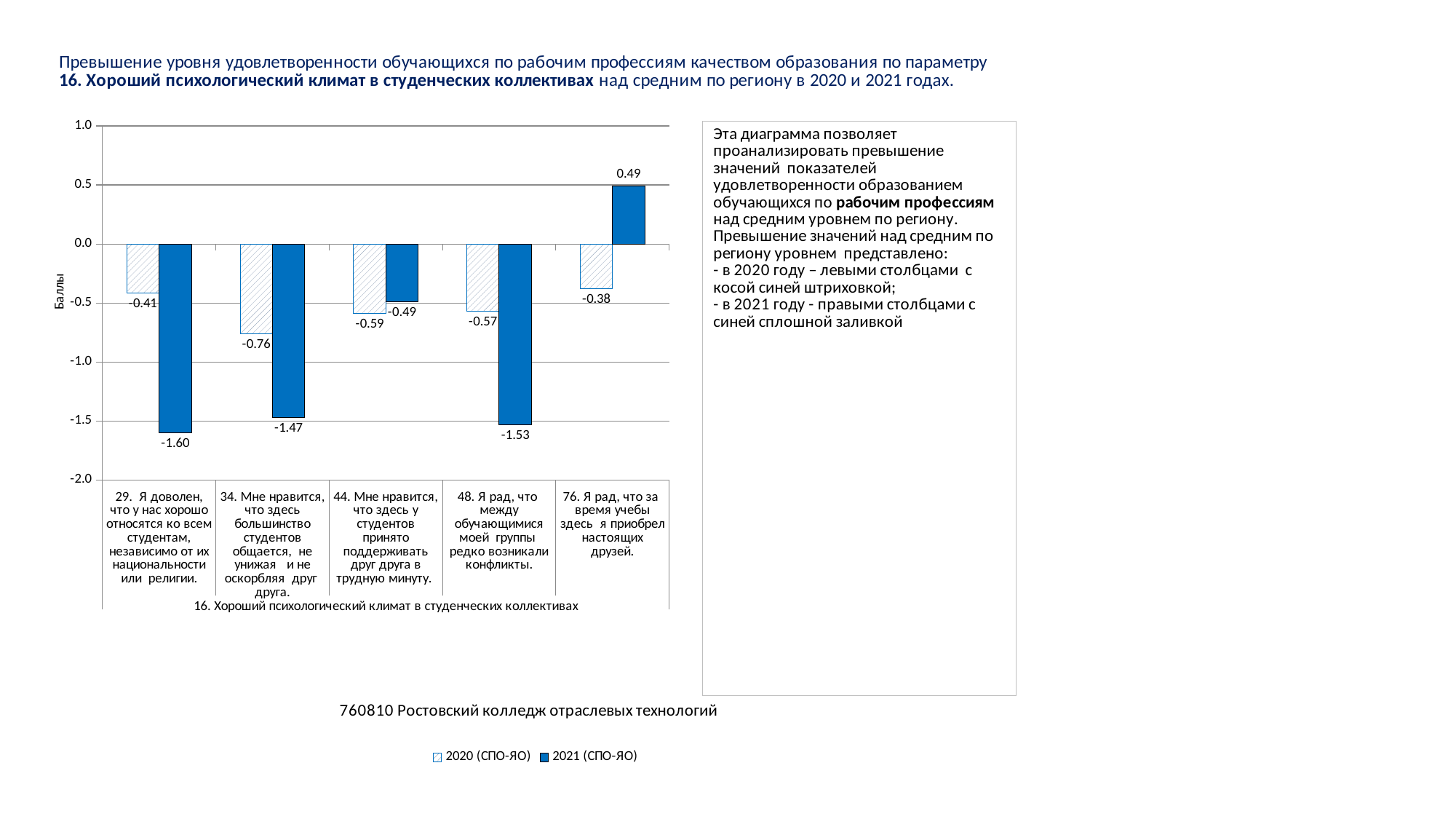
Какое значение показано для 2021 (СПО-ЯО) по категории «76. Я рад, что за время учебы здесь я приобрел настоящих друзей.»? 0.49 Какое значение больше по категории «44. Мне нравится, что здесь у студентов принято поддерживать друг друга в трудную минуту.»: 2020 (СПО-ЯО) или 2021 (СПО-ЯО)? 2021 (СПО-ЯО) Какова разница между значениями 2020 (СПО-ЯО) и 2021 (СПО-ЯО) по категории «29. Я доволен, что у нас хорошо относятся ко всем студентам, независимо от их национальности или религии.»? 1.19 Какое значение показано для 2020 (СПО-ЯО) по категории «34. Мне нравится, что здесь большинство студентов общается, не унижая и не оскорбляя друг друга.»? -0.76 По какой категории значение 2021 (СПО-ЯО) самое низкое? 29. Я доволен, что у нас хорошо относятся ко всем студентам, независимо от их национальности или религии. По какой категории значение 2020 (СПО-ЯО) самое высокое? 76. Я рад, что за время учебы здесь я приобрел настоящих друзей. Какое значение показано для 2021 (СПО-ЯО) по категории «48. Я рад, что между обучающимися моей группы редко возникали конфликты.»? -1.53 Какое значение показано для 2020 (СПО-ЯО) по категории «29. Я доволен, что у нас хорошо относятся ко всем студентам, независимо от их национальности или религии.»? -0.41 Сколько рядов данных перечислено в легенде диаграммы? 2 Сколько категорий показано на диаграмме? 5 Как называется ось значений (вертикальная ось) диаграммы? Баллы Какого типа эта диаграмма? Столбчатая (bar chart)